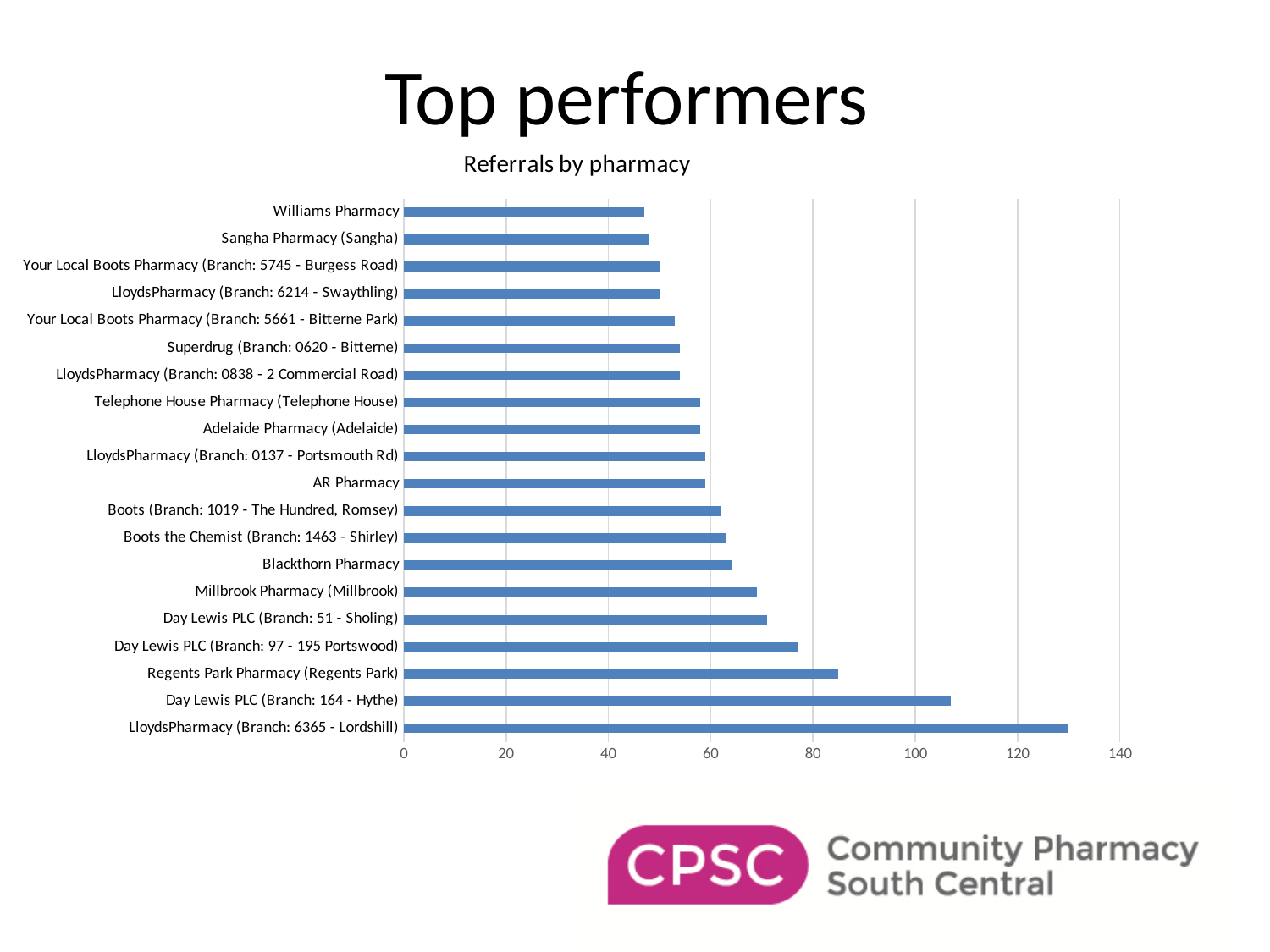
Is the value for Regents Park Pharmacy (Regents Park) greater or less than 80? greater Is the value for LloydsPharmacy (Branch: 6365 - Lordshill) greater or less than 120? greater Which has more referrals, Day Lewis PLC (Branch: 164 - Hythe) or Day Lewis PLC (Branch: 51 - Sholing)? Day Lewis PLC (Branch: 164 - Hythe) What kind of chart is shown on the slide? bar chart How many pharmacies are shown in the chart? 20 Which pharmacy has the highest number of referrals? LloydsPharmacy (Branch: 6365 - Lordshill) Is the value for Williams Pharmacy greater or less than 60? less Which has more referrals, Regents Park Pharmacy (Regents Park) or Millbrook Pharmacy (Millbrook)? Regents Park Pharmacy (Regents Park) What is the title of the chart? Referrals by pharmacy